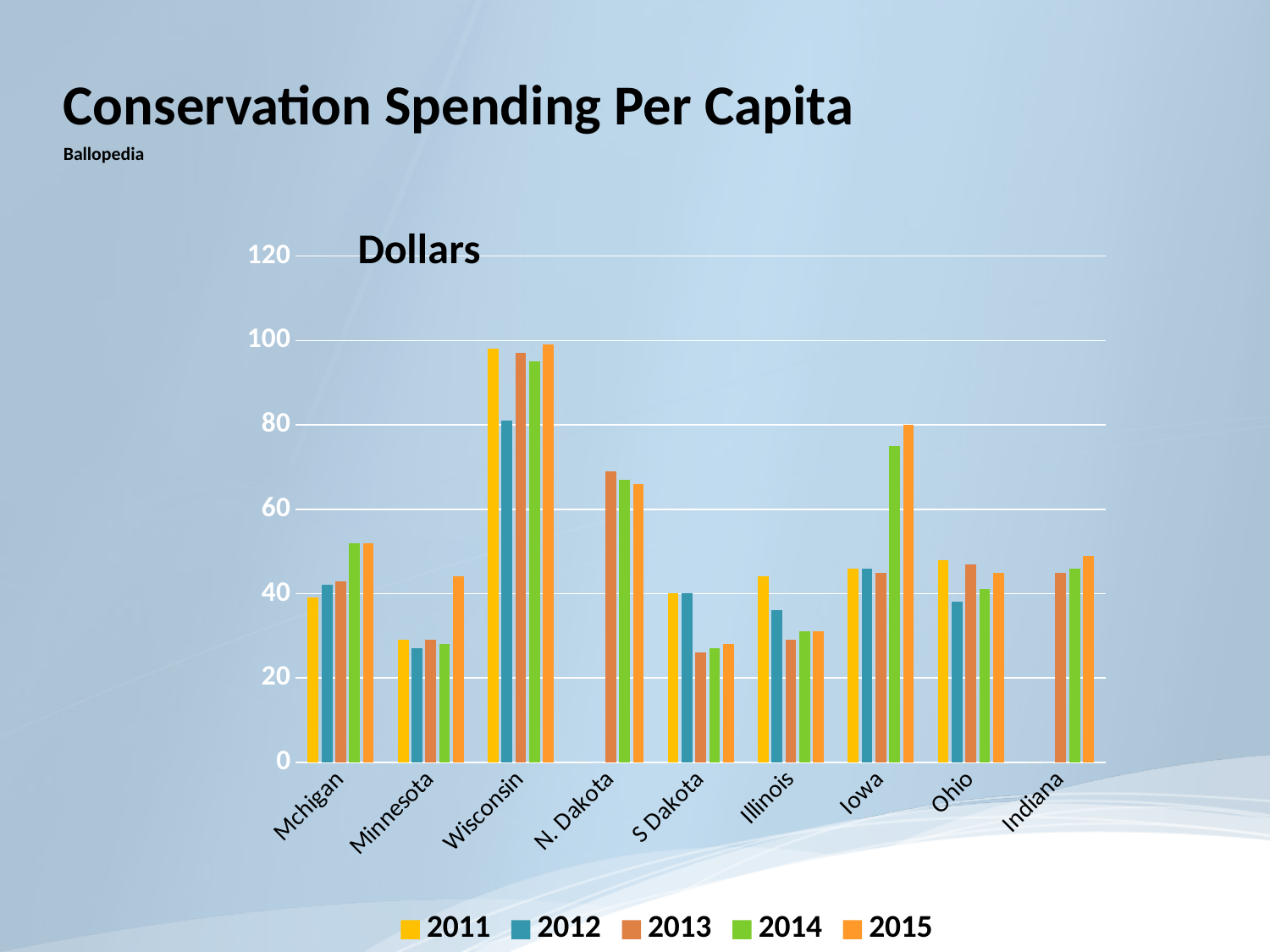
Which is larger for Iowa: the 2013 value or the 2014 value? 2014 Is the value for N. Dakota in 2013 greater or less than 60? greater How many states are shown along the x axis? 9 What is the label shown on the vertical axis of the chart? Dollars Is the value for Minnesota in 2012 greater or less than 40? less Which state has the highest conservation spending per capita in 2015? Wisconsin Is the value for Iowa in 2014 greater or less than 60? greater What kind of chart is shown on the slide? bar chart How many series does the legend list? 5 Which state has the larger 2011 value: Wisconsin or Minnesota? Wisconsin